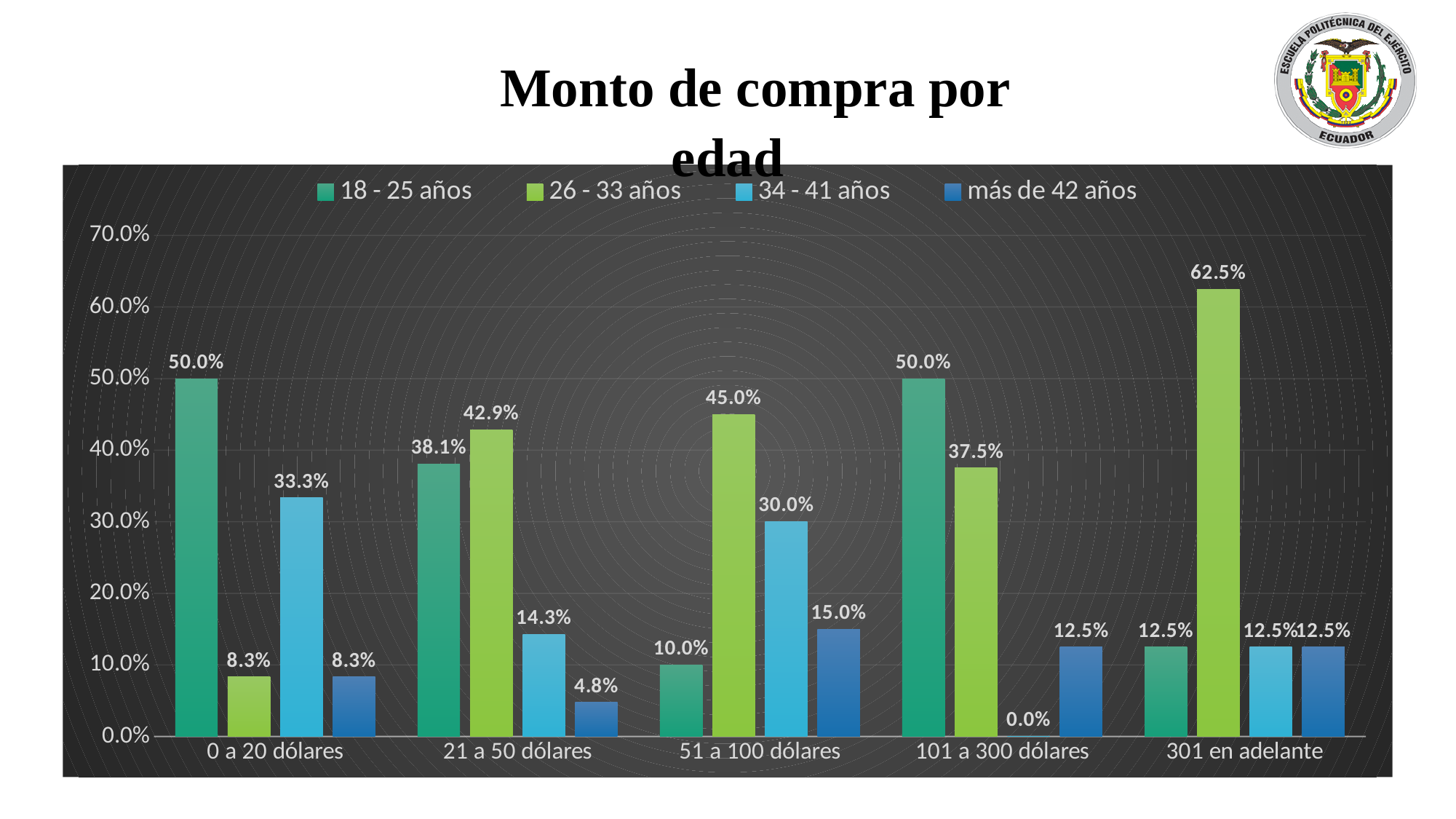
What is the value for 18 - 25 años in the 0 a 20 dólares category? 50.0% How many purchase-amount categories are shown on the x axis? 5 Which series has the highest value in the 51 a 100 dólares category? 26 - 33 años What is the value for 26 - 33 años in the 301 en adelante category? 62.5% What is the value for 34 - 41 años in the 101 a 300 dólares category? 0.0% What is the difference between the 26 - 33 años value and the 18 - 25 años value in the 301 en adelante category? 50.0% What is the value for más de 42 años in the 21 a 50 dólares category? 4.8% How many series does the legend list? 4 Which series has the lowest value in the 21 a 50 dólares category? más de 42 años In the 0 a 20 dólares category, which is larger: the value for 34 - 41 años or the value for 26 - 33 años? 34 - 41 años What is the title of the chart? Monto de compra por edad What type of chart is shown on the slide? bar chart